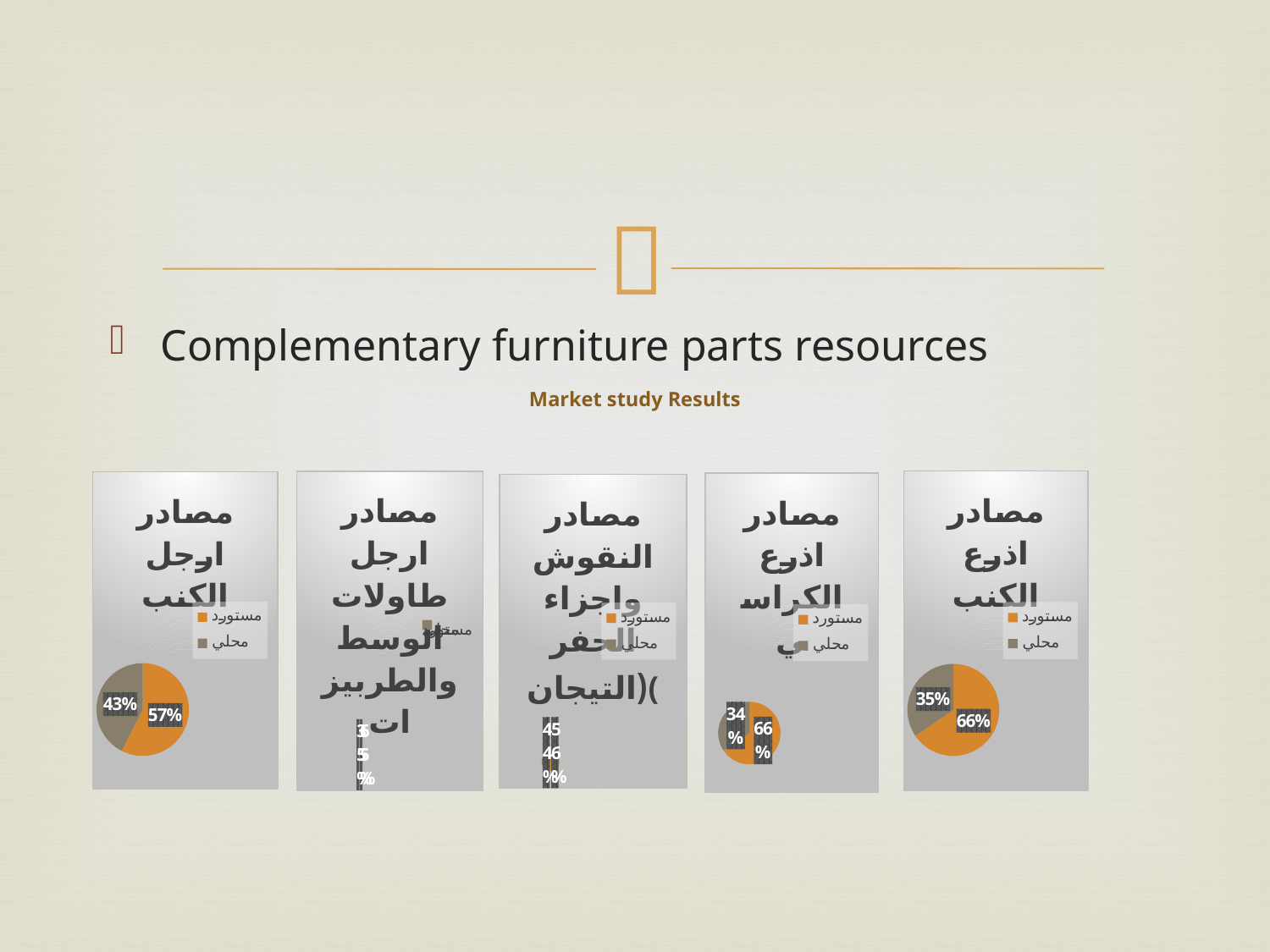
In the leftmost pie chart (مصادر ارجل الكنب), which category has the larger share, مستورد or محلي? مستورد What type of chart is used in the leftmost chart (مصادر ارجل الكنب)? Pie chart In the leftmost pie chart (مصادر ارجل الكنب), what percentage is shown for مستورد? 57% How many series does the legend of the leftmost chart (مصادر ارجل الكنب) list? 2 In the rightmost pie chart (مصادر اذرع الكنب), what percentage is shown for محلي? 35% In the rightmost pie chart (مصادر اذرع الكنب), what percentage is shown for مستورد? 66% In the fourth chart from the left (مصادر اذرع الكراسي), what is the larger of the two percentages shown? 66% In the leftmost pie chart (مصادر ارجل الكنب), what percentage is shown for محلي? 43% In the rightmost pie chart (مصادر اذرع الكنب), what is the difference between the مستورد and محلي shares? 31% In the rightmost pie chart (مصادر اذرع الكنب), which category has the larger share? مستورد In the leftmost pie chart (مصادر ارجل الكنب), what is the difference between the مستورد and محلي shares? 14% In the rightmost chart (مصادر اذرع الكنب), which colour represents مستورد in the legend? Orange